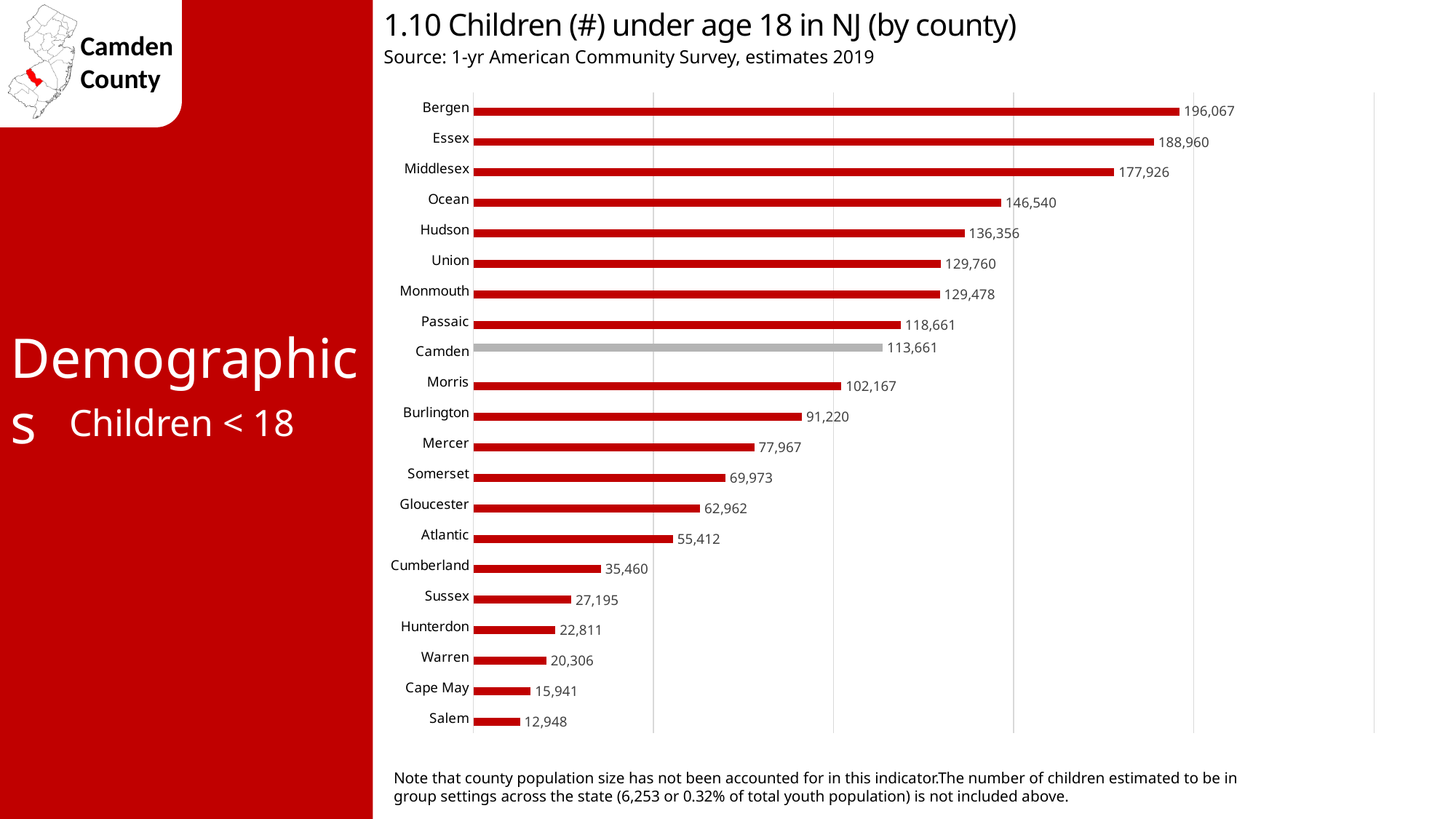
Which county's bar is shown in grey rather than red? Camden What is the difference between the number of children under 18 in Passaic and Camden counties? 5,000 Which county has more children under age 18, Morris or Burlington? Morris What is the number of children under age 18 in Camden county? 113,661 What is the number of children under age 18 in Gloucester county? 62,962 How many counties are shown in the chart? 21 What is the number of children under age 18 in Ocean county? 146,540 Which county has more children under age 18, Cape May or Warren? Warren What is the difference between the number of children under 18 in Bergen and Essex counties? 7,107 Which county has the highest number of children under age 18? Bergen What type of chart is used to show children under age 18 by county? Bar chart Which county has the lowest number of children under age 18? Salem